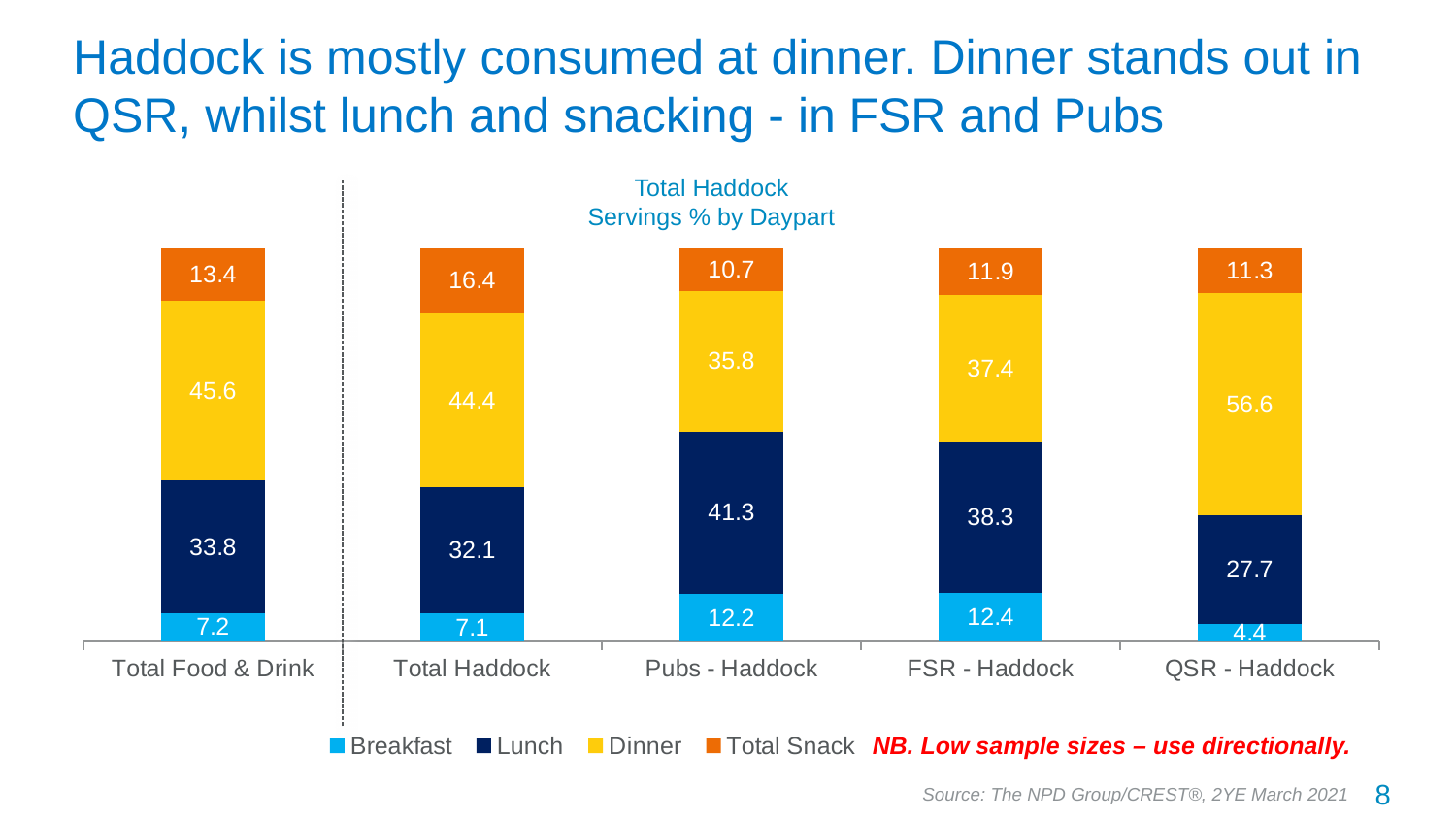
What is the difference between the Lunch values for Pubs - Haddock and QSR - Haddock? 13.6 Which category has the lowest Breakfast value? QSR - Haddock What is the Lunch value for Pubs - Haddock? 41.3 What is the Dinner value for QSR - Haddock? 56.6 Which is larger, the Total Snack value for Total Haddock or for Total Food & Drink? Total Haddock What is the Breakfast value for Total Haddock? 7.1 What is the Total Snack value for FSR - Haddock? 11.9 What kind of chart is shown on the slide? Stacked bar chart How many categories are shown on the x axis? 5 How many series does the legend list? 4 What is the total of the stacked bar for FSR - Haddock? 100.0 Which category has the highest Dinner value? QSR - Haddock